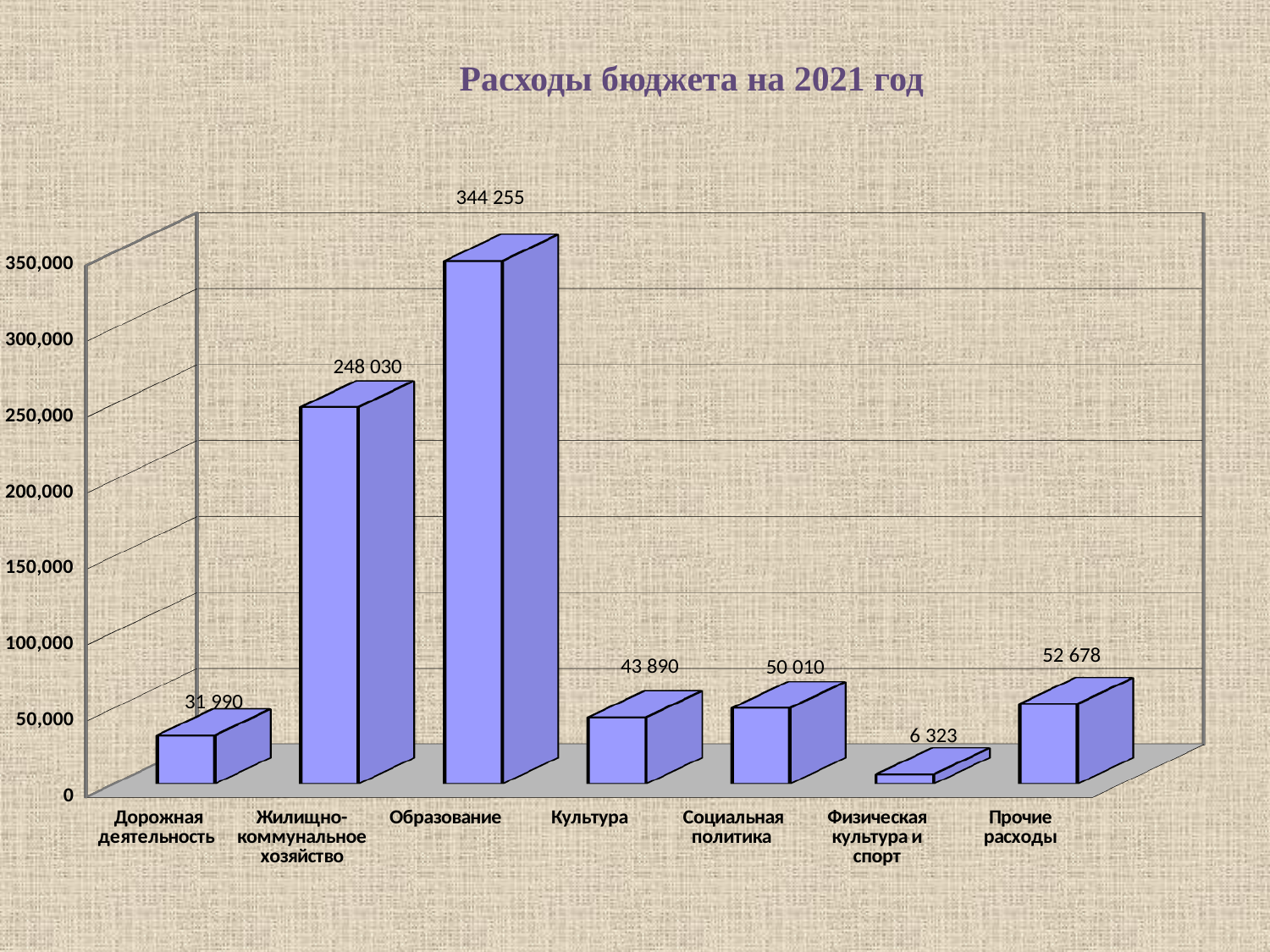
Is the value for Жилищно-коммунальное хозяйство greater or less than 200,000? greater What is the difference between the values for Прочие расходы and Социальная политика? 2 668 What is the title of the chart? Расходы бюджета на 2021 год What is the value for Образование? 344 255 What is the value for Жилищно-коммунальное хозяйство? 248 030 Which category has the highest value? Образование What is the value for Социальная политика? 50 010 How many categories are shown on the chart? 7 Which category has the lowest value? Физическая культура и спорт What is the difference between the values for Образование and Жилищно-коммунальное хозяйство? 96 225 Which is larger, the value for Культура or the value for Дорожная деятельность? Культура What is the value for Физическая культура и спорт? 6 323